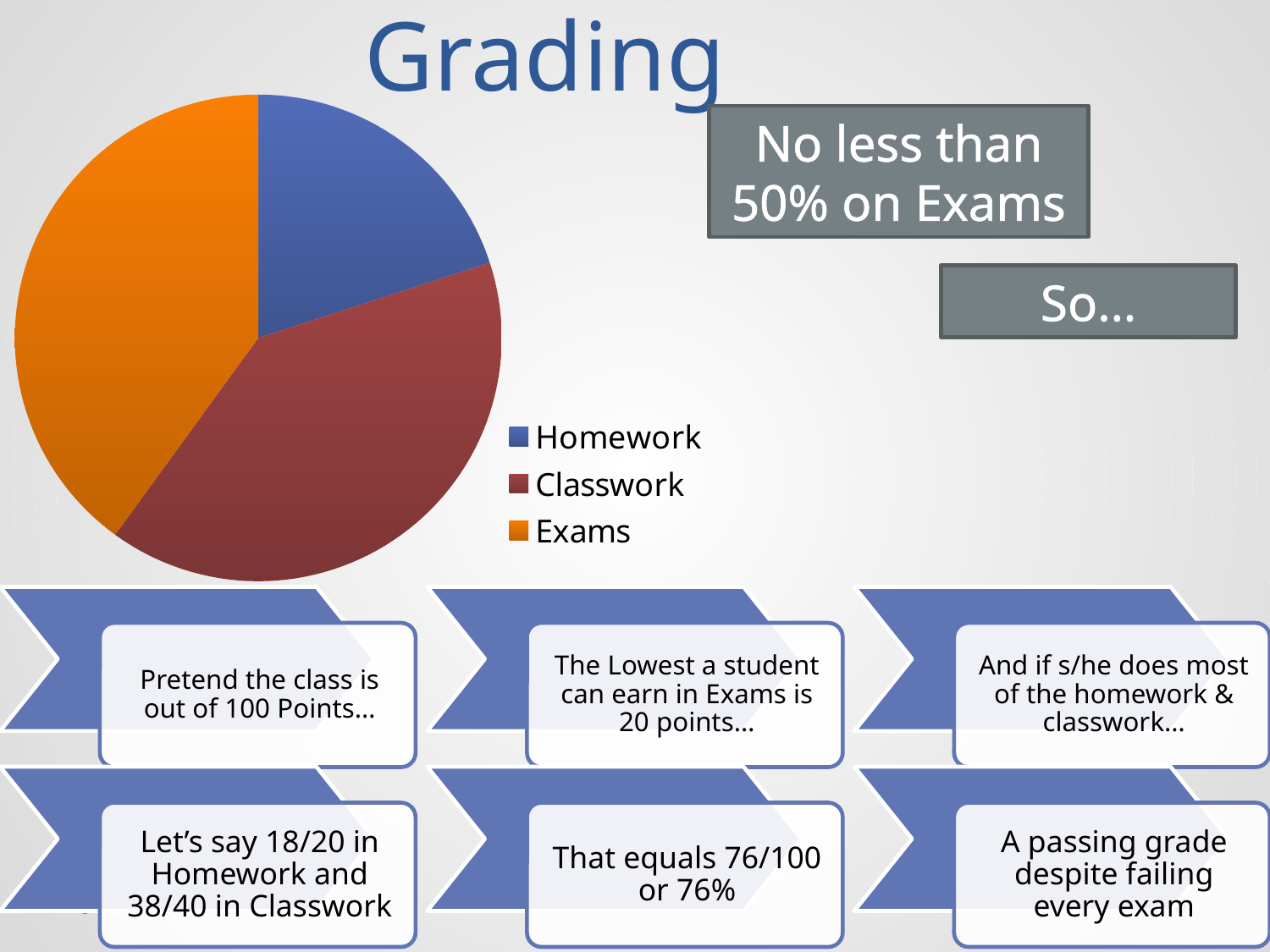
Which category has the smallest slice in the pie chart? Homework What kind of chart is shown on the slide? pie chart Which slice is larger in the pie chart, Homework or Classwork? Classwork How many entries does the legend of the pie chart list? 3 How many slices does the pie chart have? 3 Which category is shown in blue in the pie chart? Homework What colour is the Exams slice in the pie chart? orange Which slice is larger in the pie chart, Homework or Exams? Exams